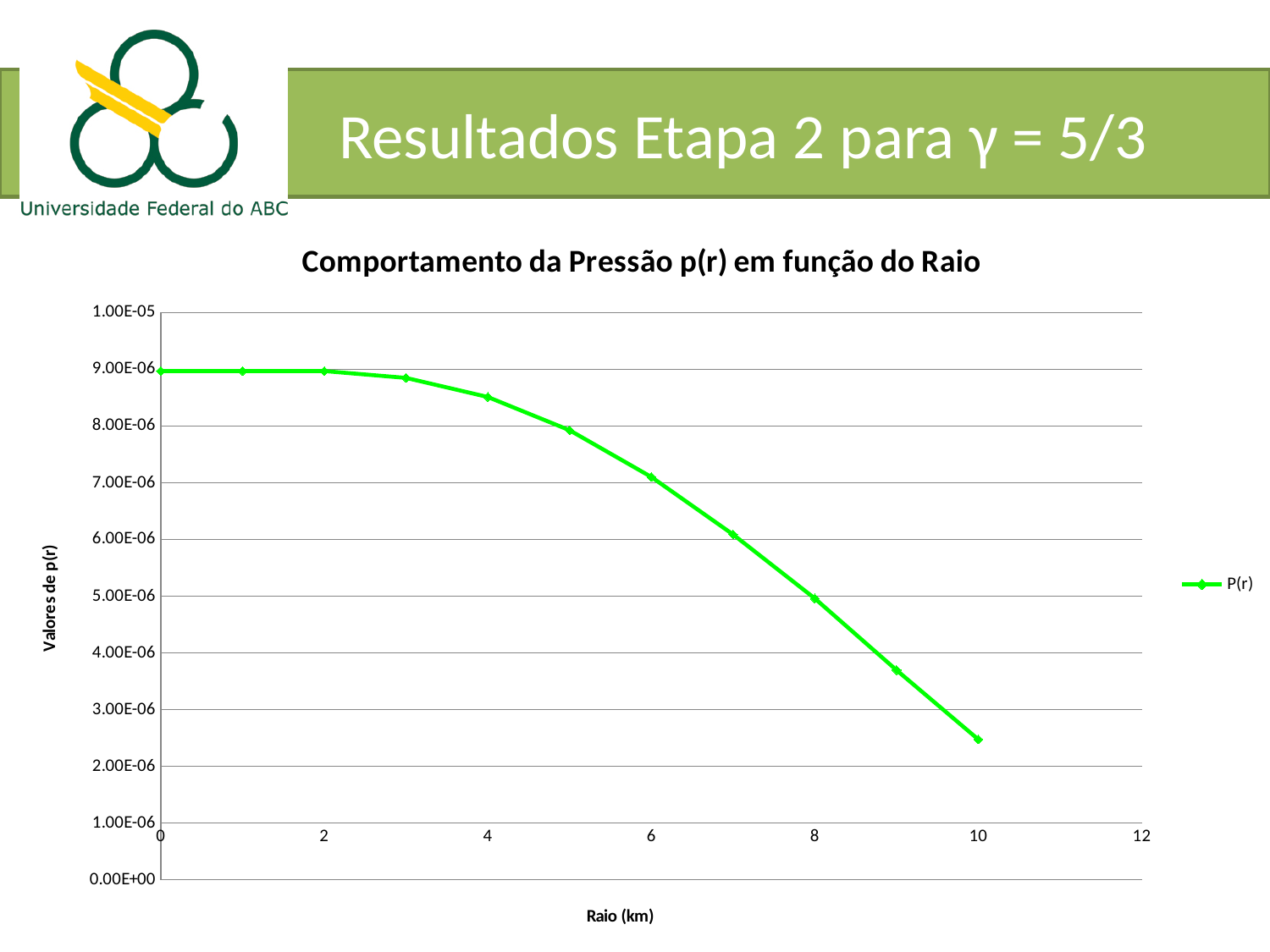
Is the value of P(r) at a radius of 10 km greater or less than 3.00E-06? less Which is larger, the value of P(r) at a radius of 3 km or at a radius of 8 km? 3 km What is the name of the series shown in the legend? P(r) What is the title of the chart? Comportamento da Pressão p(r) em função do Raio Is the value of P(r) at a radius of 0 km greater or less than 8.00E-06? greater Do the values of P(r) rise or fall as the radius increases along the x axis? fall At which radius (km) is the value of P(r) lowest? 10 What kind of chart is shown on the slide? line chart How many data points are plotted on the P(r) line? 11 How many series does the legend list? 1 Is the value of P(r) at a radius of 4 km greater or less than 8.00E-06? greater